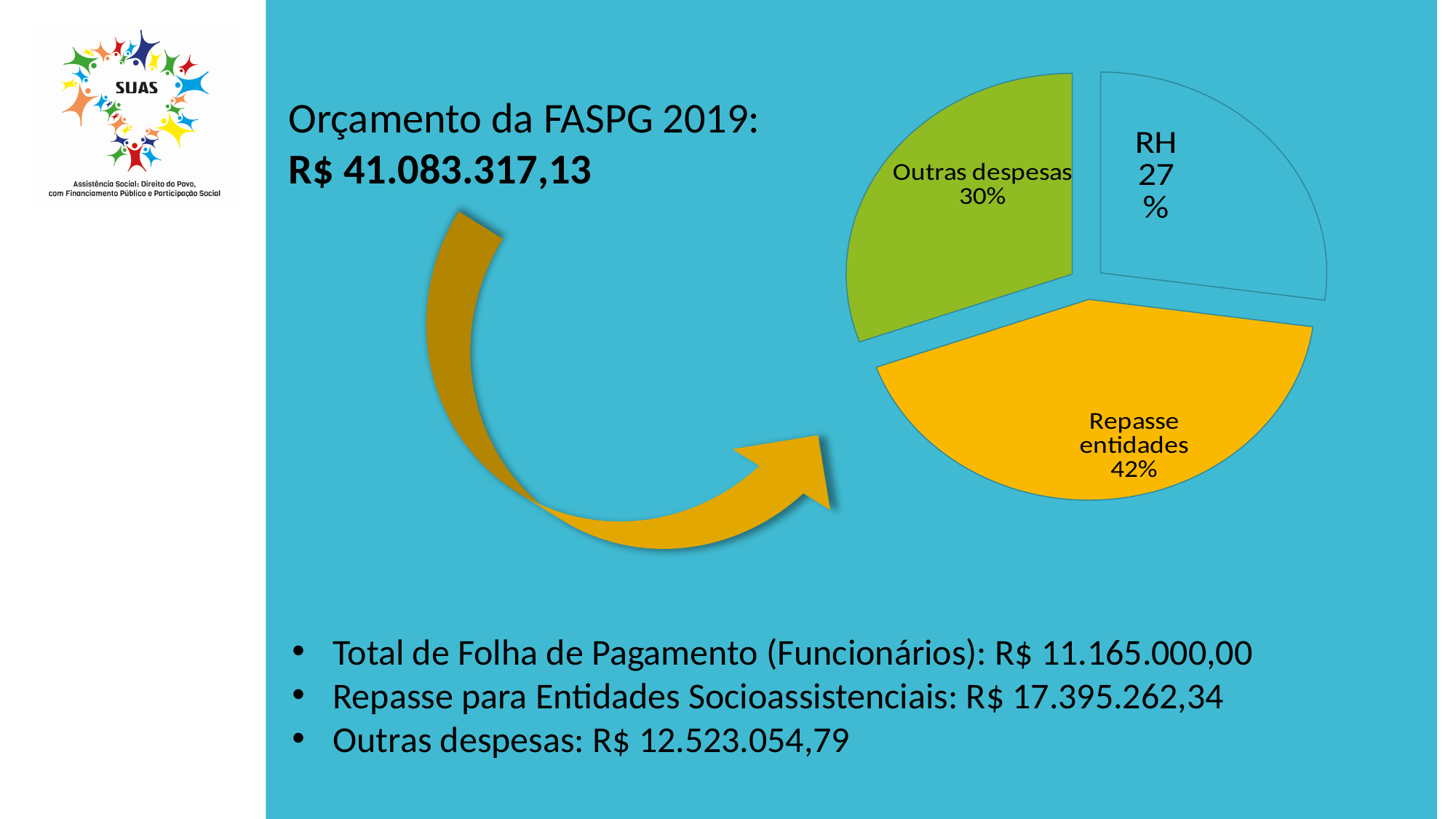
What is the difference in percentage points between Outras despesas and RH? 3 What colour is the Outras despesas slice? green How many slices does the pie chart have? 3 Which slice of the pie chart is the largest? Repasse entidades Which is larger, the Outras despesas slice or the Repasse entidades slice? Repasse entidades What share of the pie does Repasse entidades represent? 42% What share of the pie does RH represent? 27% Which slice of the pie chart is the smallest? RH What share of the pie does Outras despesas represent? 30% What is the difference in percentage points between Repasse entidades and RH? 15 What colour is the Repasse entidades slice? yellow What kind of chart is shown on the slide? pie chart